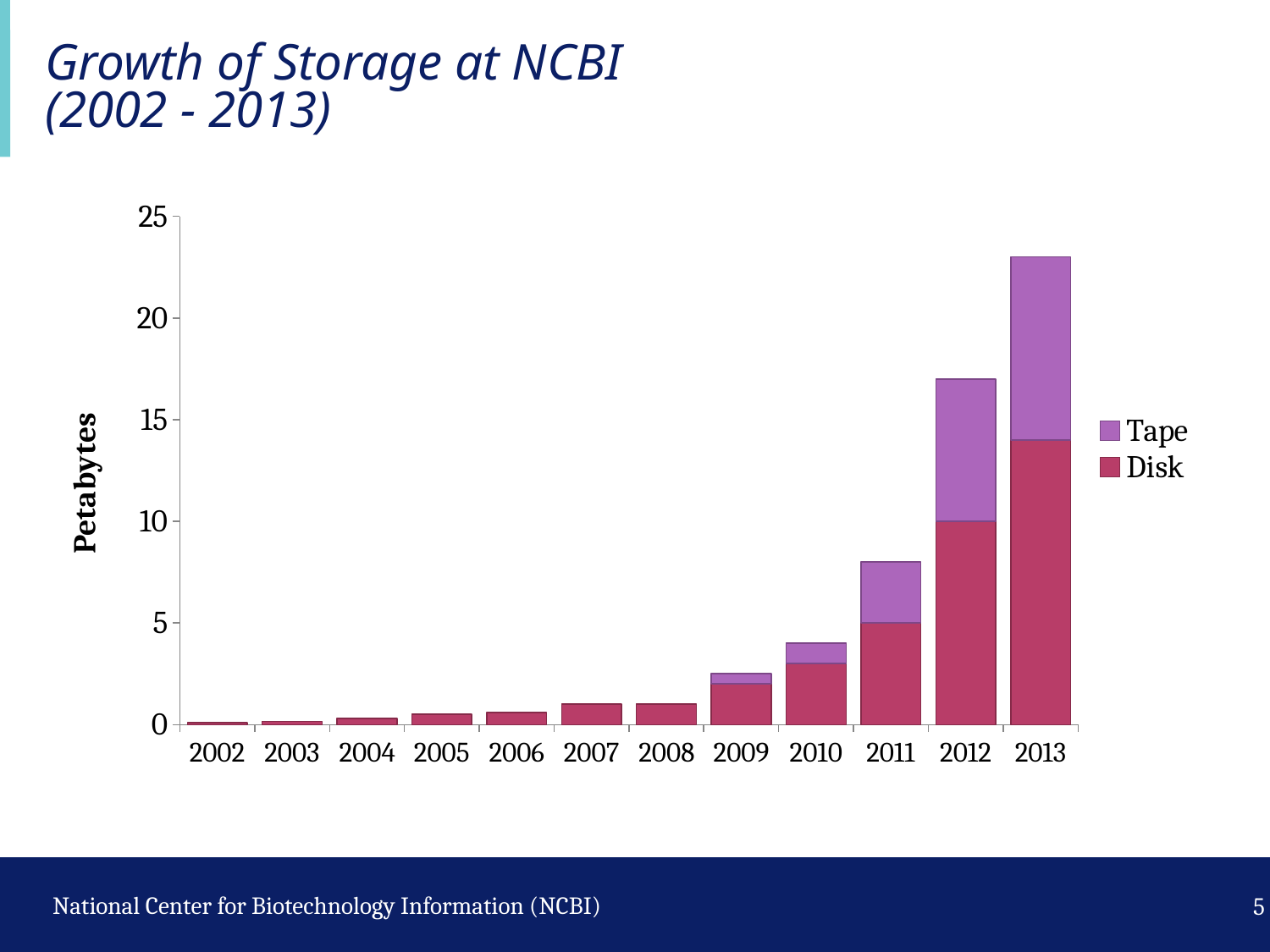
How many series does the legend list? 2 What is the label on the y axis? Petabytes Which series is shown in the lighter purple colour? Tape What kind of chart is shown on the slide? stacked bar chart Do the total storage values rise or fall from 2002 to 2013? rise Which year has the tallest total bar? 2013 Is the total value for 2010 greater or less than 5? less How many years are shown along the x axis? 12 Which year has the smallest total bar? 2002 Which is larger in 2013, the Disk segment or the Tape segment? Disk Is the total value for 2013 greater or less than 20? greater Is the total value for 2012 greater or less than 15? greater